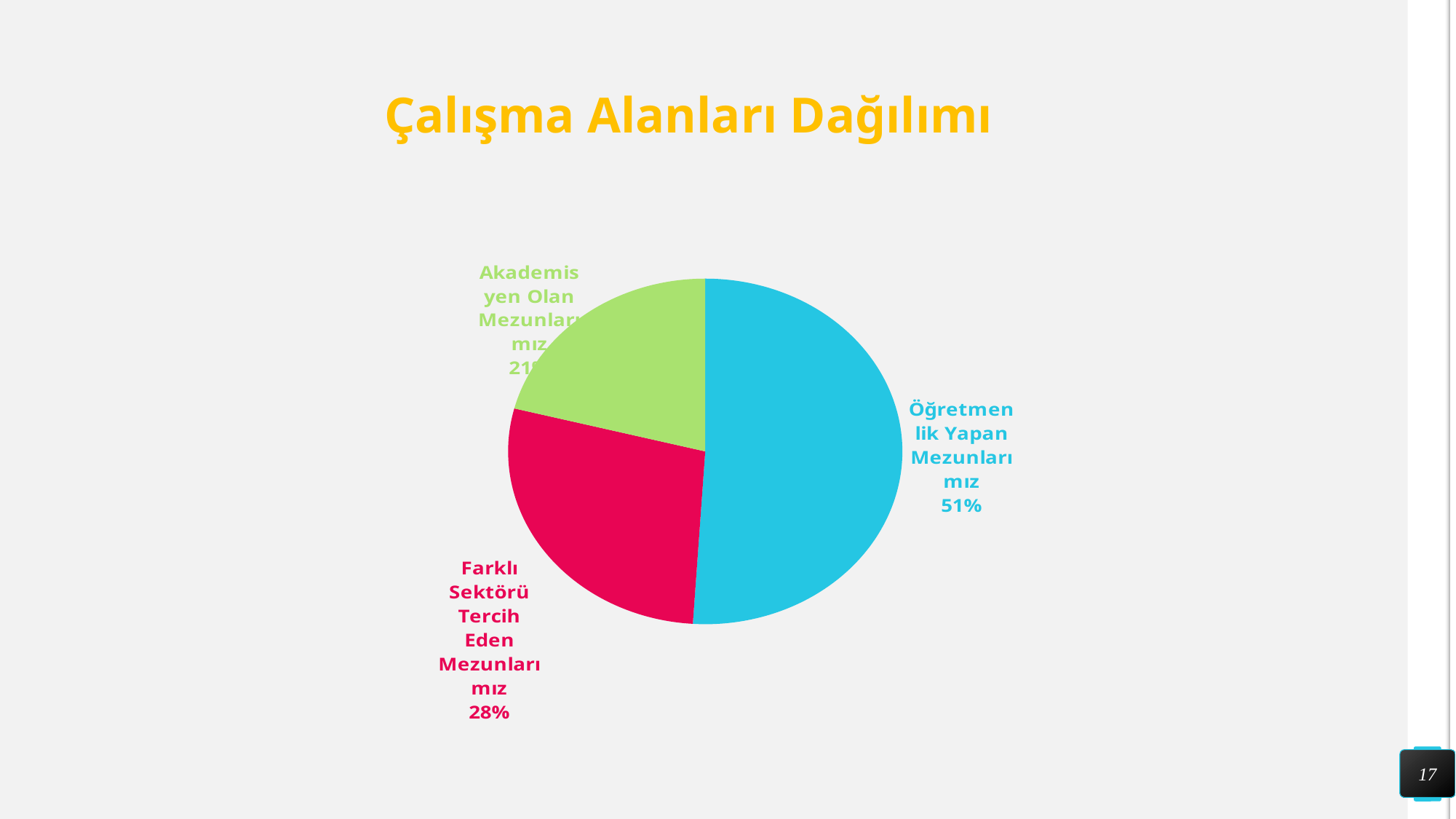
Which category has the largest share of the pie? Öğretmenlik Yapan Mezunlarımız What percentage of the pie is 'Öğretmenlik Yapan Mezunlarımız'? 51% What percentage of the pie is 'Farklı Sektörü Tercih Eden Mezunlarımız'? 28% Which category has the smallest share of the pie? Akademisyen Olan Mezunlarımız Which is larger: the share for 'Öğretmenlik Yapan Mezunlarımız' or for 'Farklı Sektörü Tercih Eden Mezunlarımız'? Öğretmenlik Yapan Mezunlarımız How many slices does the pie chart have? 3 What is the title of the chart? Çalışma Alanları Dağılımı What colour is the slice for 'Farklı Sektörü Tercih Eden Mezunlarımız'? Red (pink) What is the difference in percentage points between 'Öğretmenlik Yapan Mezunlarımız' and 'Farklı Sektörü Tercih Eden Mezunlarımız'? 23 Does 'Öğretmenlik Yapan Mezunlarımız' account for more or less than half of the pie? More What kind of chart is shown on the slide? Pie chart